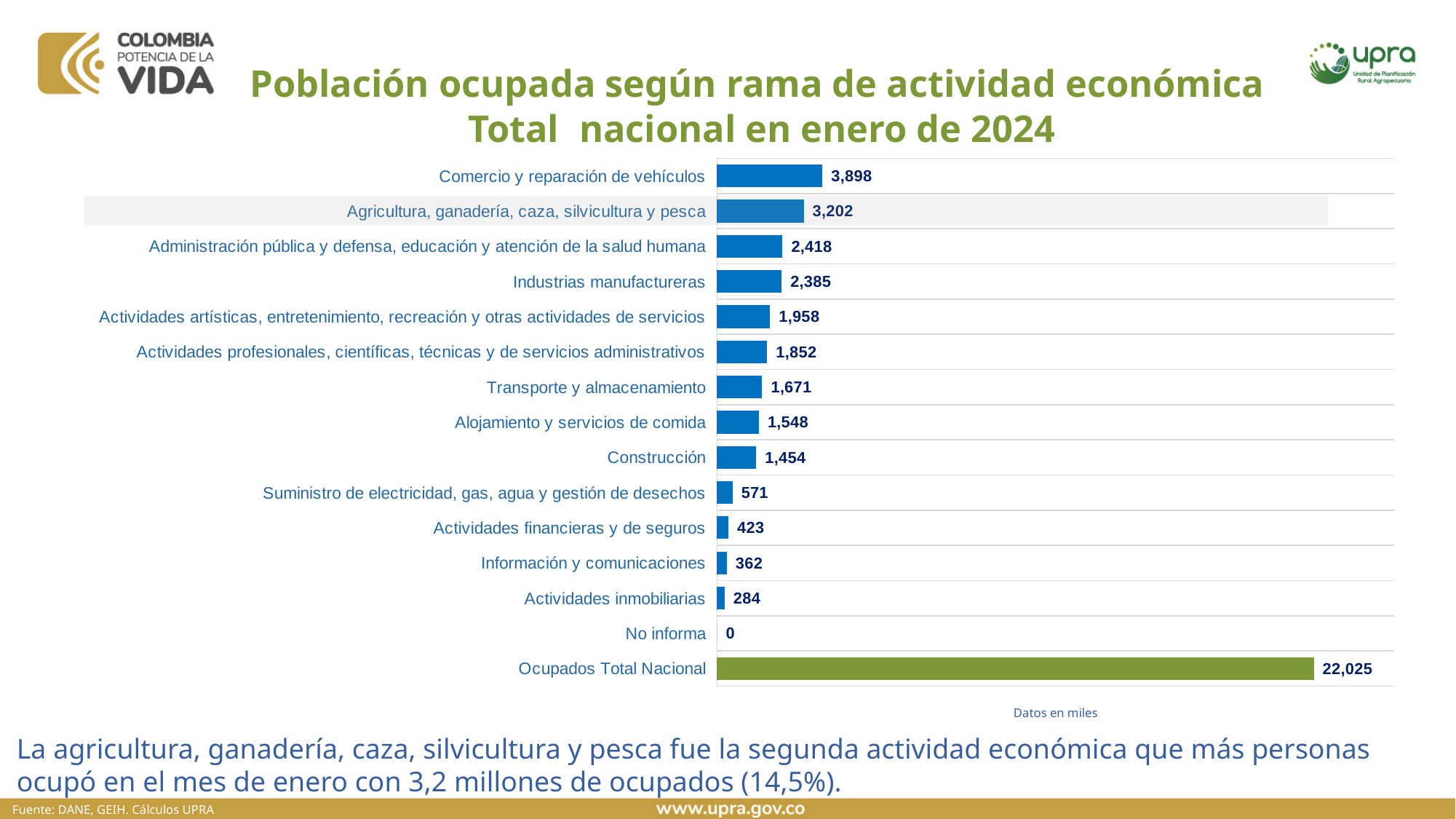
What is the difference between Comercio y reparación de vehículos and Agricultura, ganadería, caza, silvicultura y pesca? 696 What is the value for Ocupados Total Nacional? 22,025 How many categories are shown in the chart? 15 What kind of chart is shown on the slide? Bar chart Which is larger, Industrias manufactureras or Transporte y almacenamiento? Industrias manufactureras What is the value for Comercio y reparación de vehículos? 3,898 What is the difference between Actividades financieras y de seguros and Información y comunicaciones? 61 What is the value for Construcción? 1,454 What colour is the bar for Ocupados Total Nacional? Green Which category has the lowest value? No informa Excluding the Ocupados Total Nacional bar, which economic activity has the highest value? Comercio y reparación de vehículos What is the value for Agricultura, ganadería, caza, silvicultura y pesca? 3,202